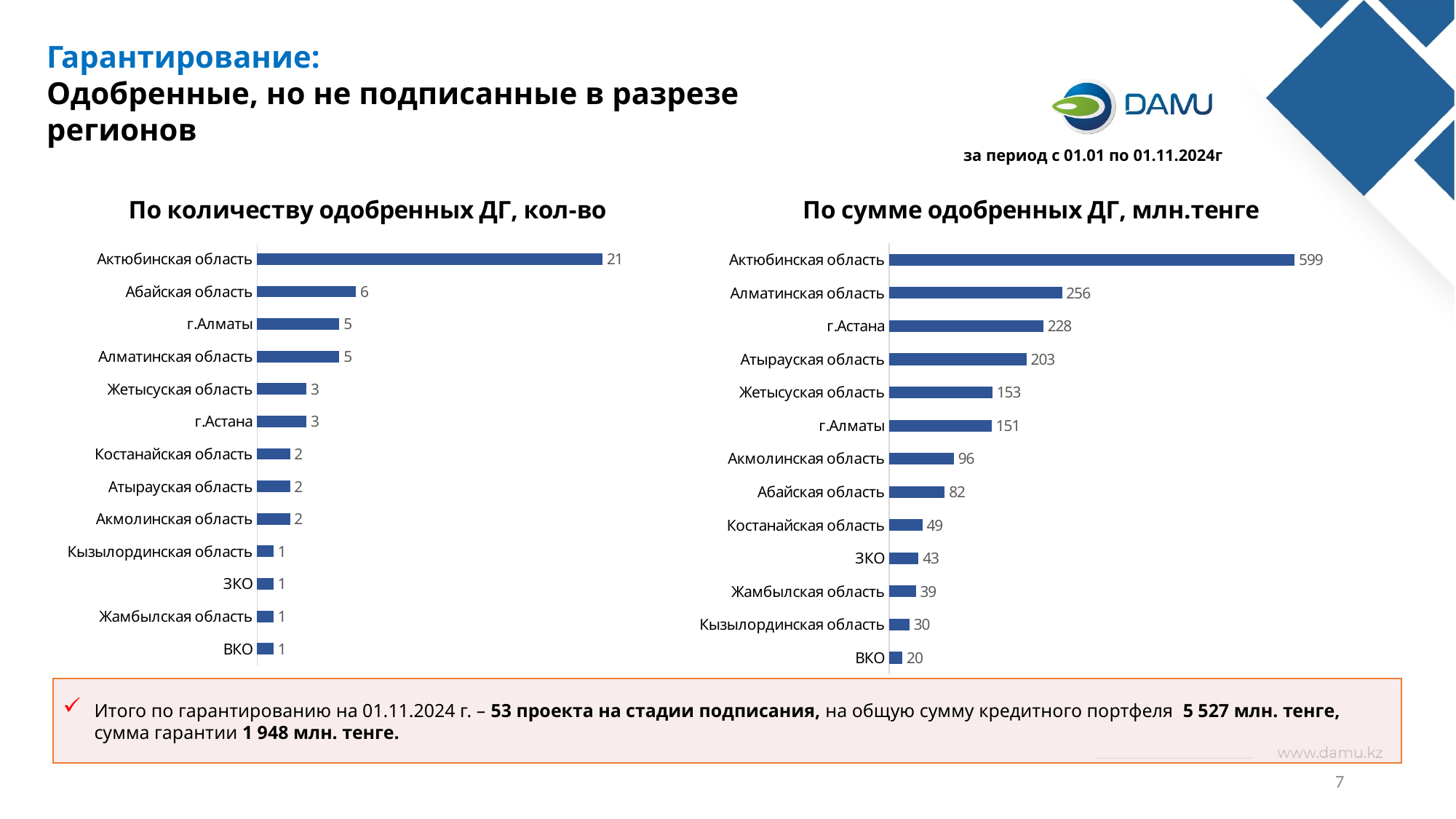
How many regions are shown in the chart 'По сумме одобренных ДГ, млн.тенге'? 13 In the chart 'По сумме одобренных ДГ, млн.тенге', which is larger: Атырауская область or Акмолинская область? Атырауская область In the chart 'По количеству одобренных ДГ, кол-во', what is the difference between Актюбинская область and Абайская область? 15 In the chart 'По сумме одобренных ДГ, млн.тенге', what is the difference between Актюбинская область and Алматинская область? 343 In the chart 'По количеству одобренных ДГ, кол-во', which is larger: Абайская область or Жетысуская область? Абайская область What type of chart is 'По количеству одобренных ДГ, кол-во'? Bar chart In the chart 'По сумме одобренных ДГ, млн.тенге', what is the value for г.Астана? 228 In the chart 'По сумме одобренных ДГ, млн.тенге', which region has the highest value? Актюбинская область In the chart 'По количеству одобренных ДГ, кол-во', which region has the highest value? Актюбинская область In the chart 'По сумме одобренных ДГ, млн.тенге', which region has the lowest value? ВКО In the chart 'По количеству одобренных ДГ, кол-во', what is the value for Актюбинская область? 21 In the chart 'По сумме одобренных ДГ, млн.тенге', what is the value for Жамбылская область? 39